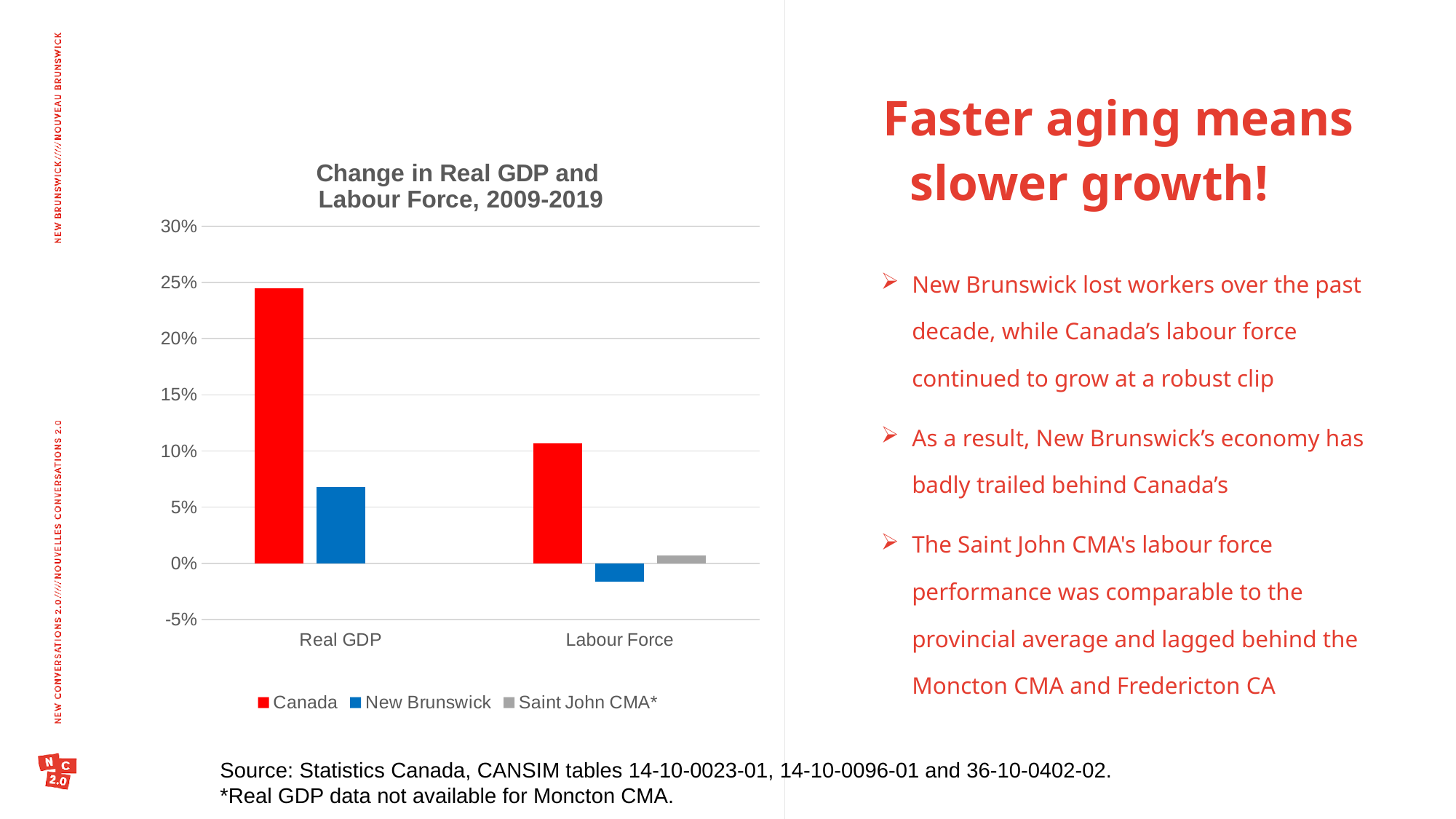
Which is larger: Canada's Real GDP change or Canada's Labour Force change? Real GDP Which series has the lowest value for Labour Force? New Brunswick Which is larger: Saint John CMA's Labour Force change or New Brunswick's Labour Force change? Saint John CMA How many categories are shown on the x axis? 2 Is the value for Canada's Labour Force greater or less than 5%? greater What kind of chart is shown on the slide? bar chart How many series does the legend list? 3 Which series has the highest value for Real GDP? Canada What is the title of the chart? Change in Real GDP and Labour Force, 2009-2019 Is the value for New Brunswick's Labour Force greater or less than 0%? less Is the value for New Brunswick's Real GDP greater or less than 10%? less